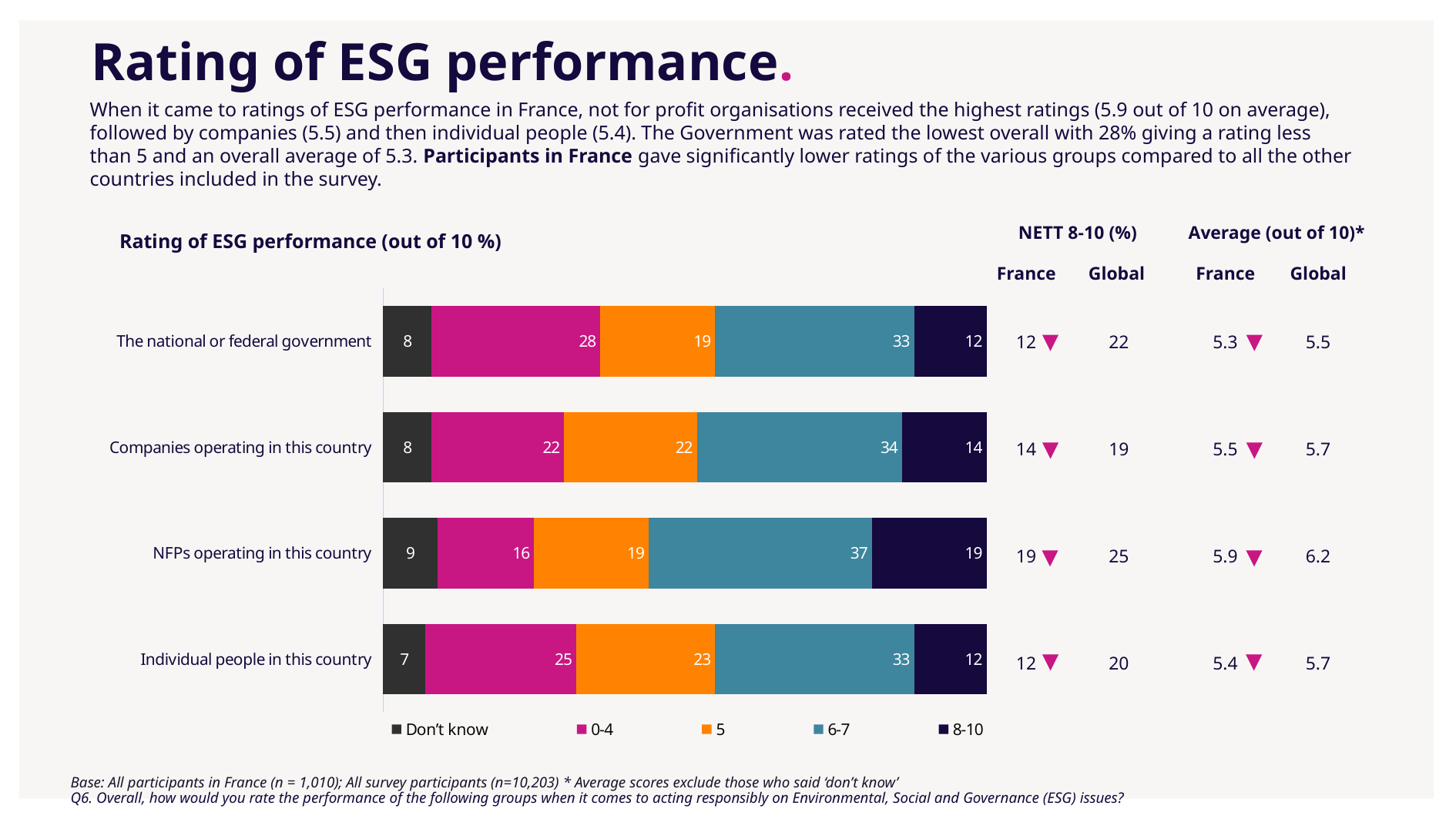
What type of chart is shown on the slide? Stacked bar chart What is the title of the chart? Rating of ESG performance (out of 10 %) What is the difference between the 0-4 value for the national or federal government and the 0-4 value for NFPs operating in this country? 12 What is the total of the stacked bar for companies operating in this country? 100 How many series does the legend list? 5 Which group has the highest value in the 6-7 segment? NFPs operating in this country What percentage of participants rated the national or federal government 0-4? 28 Which has a larger 8-10 value: companies operating in this country or the national or federal government? Companies operating in this country What is the value of the 8-10 segment for NFPs operating in this country? 19 What is the value of the 6-7 segment for companies operating in this country? 34 Which group has the lowest 'Don't know' value? Individual people in this country How many groups are shown on the chart? 4